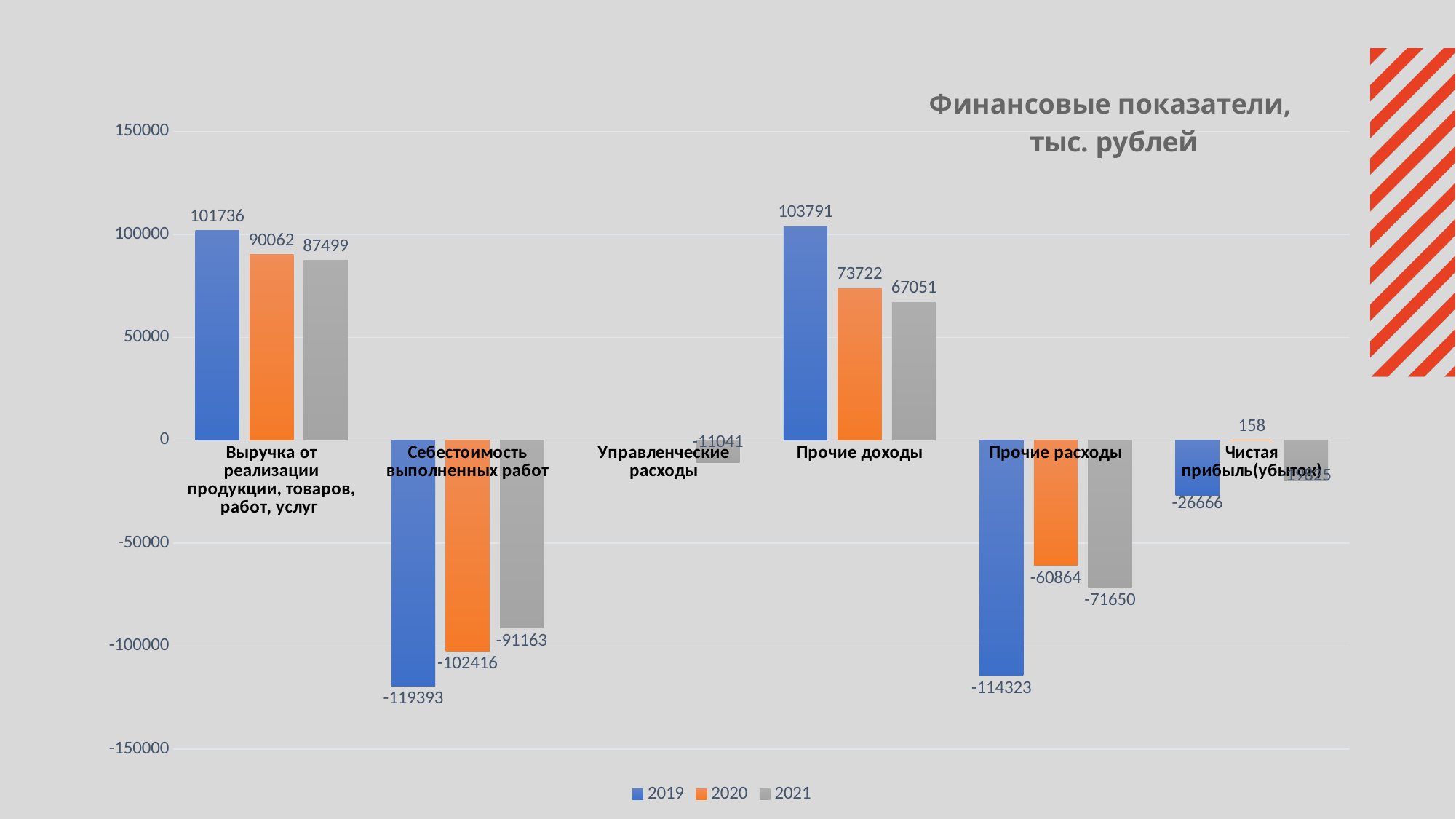
Which year has the highest value for Прочие доходы? 2019 What kind of chart is shown on the slide? bar chart Do the values for Выручка от реализации продукции, товаров, работ, услуг rise or fall from 2019 to 2021? fall What is the difference between the 2019 and 2021 values for Выручка от реализации продукции, товаров, работ, услуг? 14237 What is the 2020 value for Чистая прибыль(убыток)? 158 How many categories are shown on the x axis? 6 How many series does the legend list? 3 What is the 2019 value for Выручка от реализации продукции, товаров, работ, услуг? 101736 What is the title of the chart? Финансовые показатели, тыс. рублей What is the 2019 value for Прочие расходы? -114323 What is the 2020 value for Прочие доходы? 73722 What is the 2021 value for Себестоимость выполненных работ? -91163